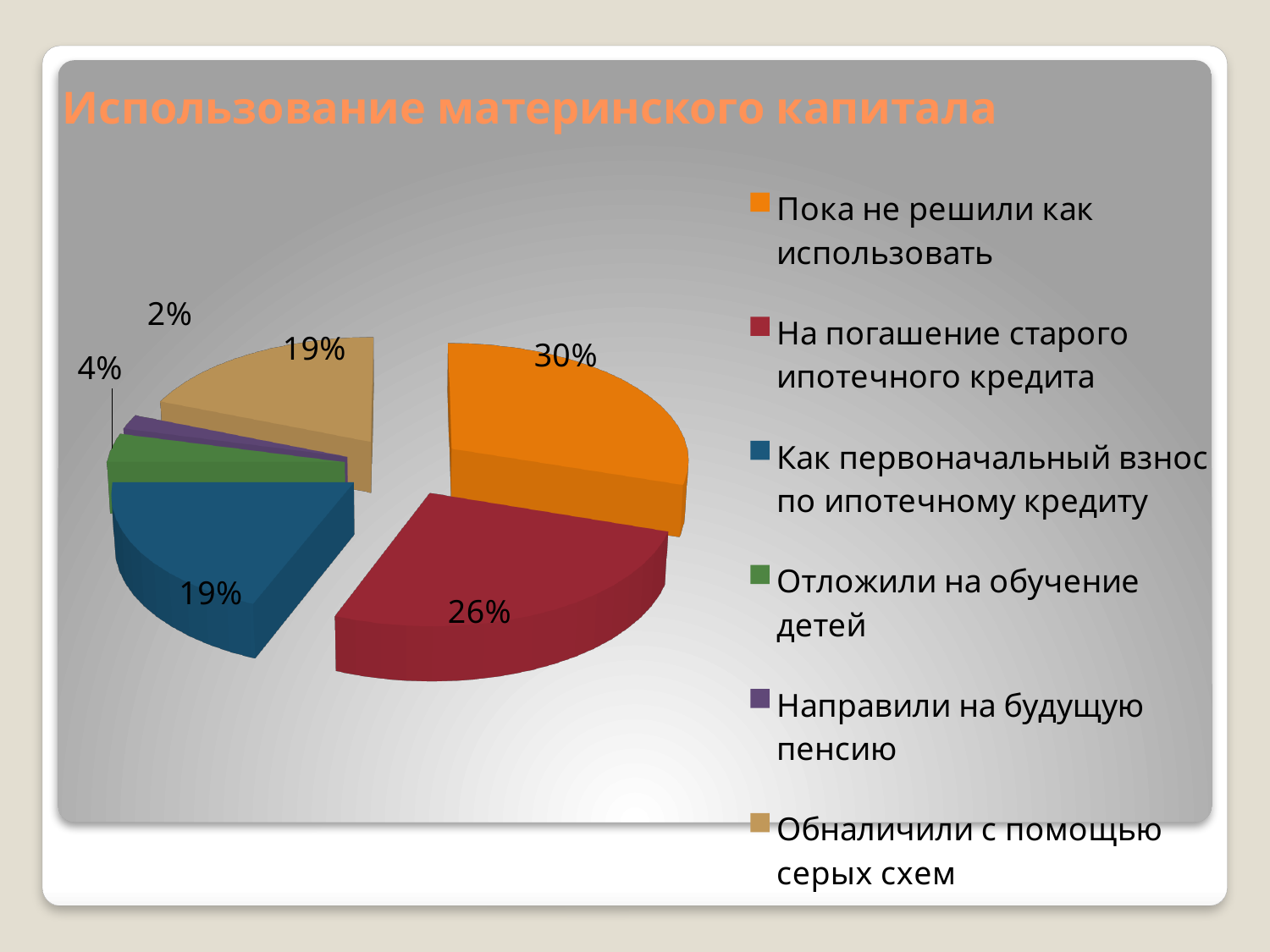
How many categories does the legend list? 6 What share of the pie is 'На погашение старого ипотечного кредита'? 26% What is the title of the chart? Использование материнского капитала What share of the pie is 'Направили на будущую пенсию'? 2% What is the difference in percentage points between 'Пока не решили как использовать' and 'На погашение старого ипотечного кредита'? 4 percentage points What share of the pie is 'Как первоначальный взнос по ипотечному кредиту'? 19% Which category has the largest share of the pie? Пока не решили как использовать What kind of chart is shown on the slide? Pie chart Which is larger: the share for 'Отложили на обучение детей' or for 'Направили на будущую пенсию'? Отложили на обучение детей Which category has the smallest share of the pie? Направили на будущую пенсию